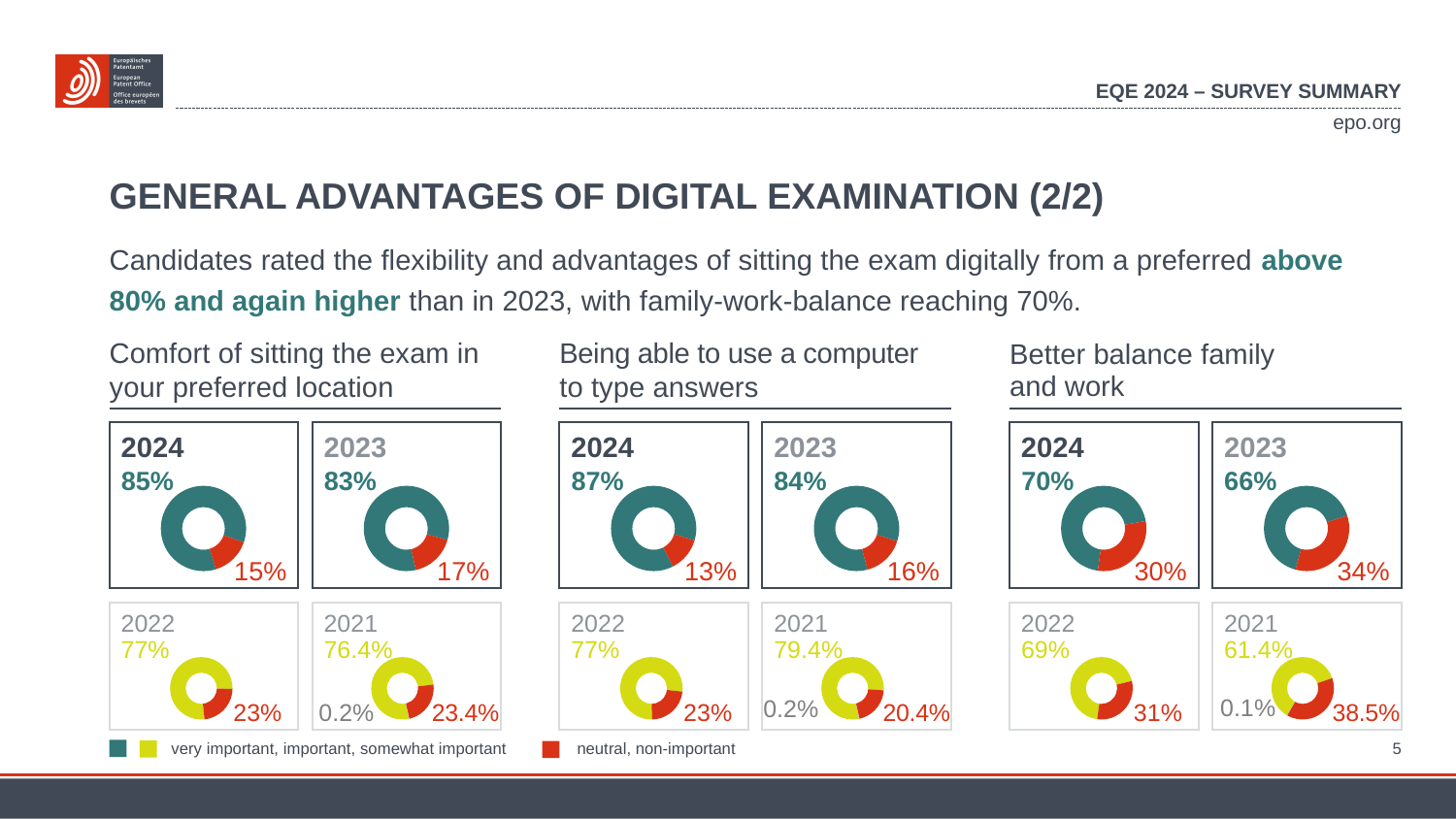
In the 'Better balance family and work' section, what is the neutral/non-important share for 2024? 30% According to the legend, what does the red colour in the charts represent? neutral, non-important In the 'Being able to use a computer to type answers' section, what is the neutral/non-important share shown for 2023? 16% In the 'Better balance family and work' section, what value is shown for 2021 for the very important/important/somewhat important group? 61.4% Across all three sections, which 2024 chart shows the highest very important/important/somewhat important share? Being able to use a computer to type answers (87%) In the 'Being able to use a computer to type answers' section, by how many percentage points did the very important/important/somewhat important share rise from 2023 to 2024? 3 percentage points What type of chart is used to show the survey results on this slide? Donut (pie) chart Which section shows the higher very important/important/somewhat important share for 2024: 'Being able to use a computer to type answers' or 'Better balance family and work'? Being able to use a computer to type answers In the 'Better balance family and work' section, which year has the lowest very important/important/somewhat important share? 2021 In the 'Comfort of sitting the exam in your preferred location' section, what share of candidates rated it very important, important or somewhat important in 2024? 85% In the 'Comfort of sitting the exam in your preferred location' section, what is the difference between the 2024 and 2022 very important/important/somewhat important shares? 8 percentage points How many years of results are shown for each of the three advantages? 4